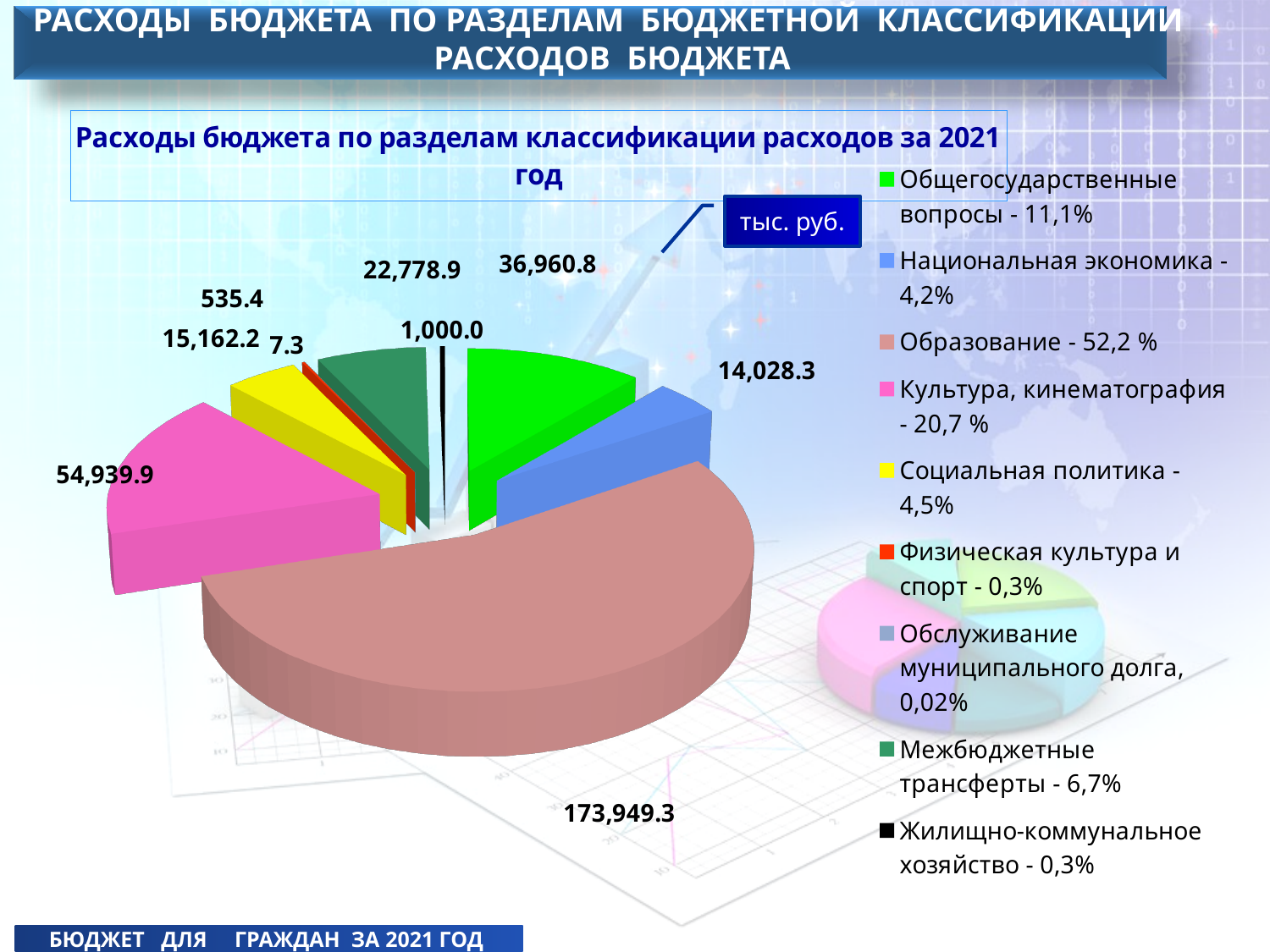
What is the difference between the values for Культура, кинематография and Общегосударственные вопросы? 17,979.1 What is the value for Общегосударственные вопросы? 36,960.8 What is the value for Межбюджетные трансферты? 22,778.9 What is the value for Образование? 173,949.3 How many sections (slices) does the pie chart have? 9 What share of the pie does Культура, кинематография have according to the legend? 20,7 % What is the value for Социальная политика? 15,162.2 What kind of chart is shown on the slide? pie chart Which is larger, the value for Социальная политика or for Национальная экономика? Социальная политика Which section has the largest share of the pie? Образование What is the value for Культура, кинематография? 54,939.9 What is the value for Национальная экономика? 14,028.3